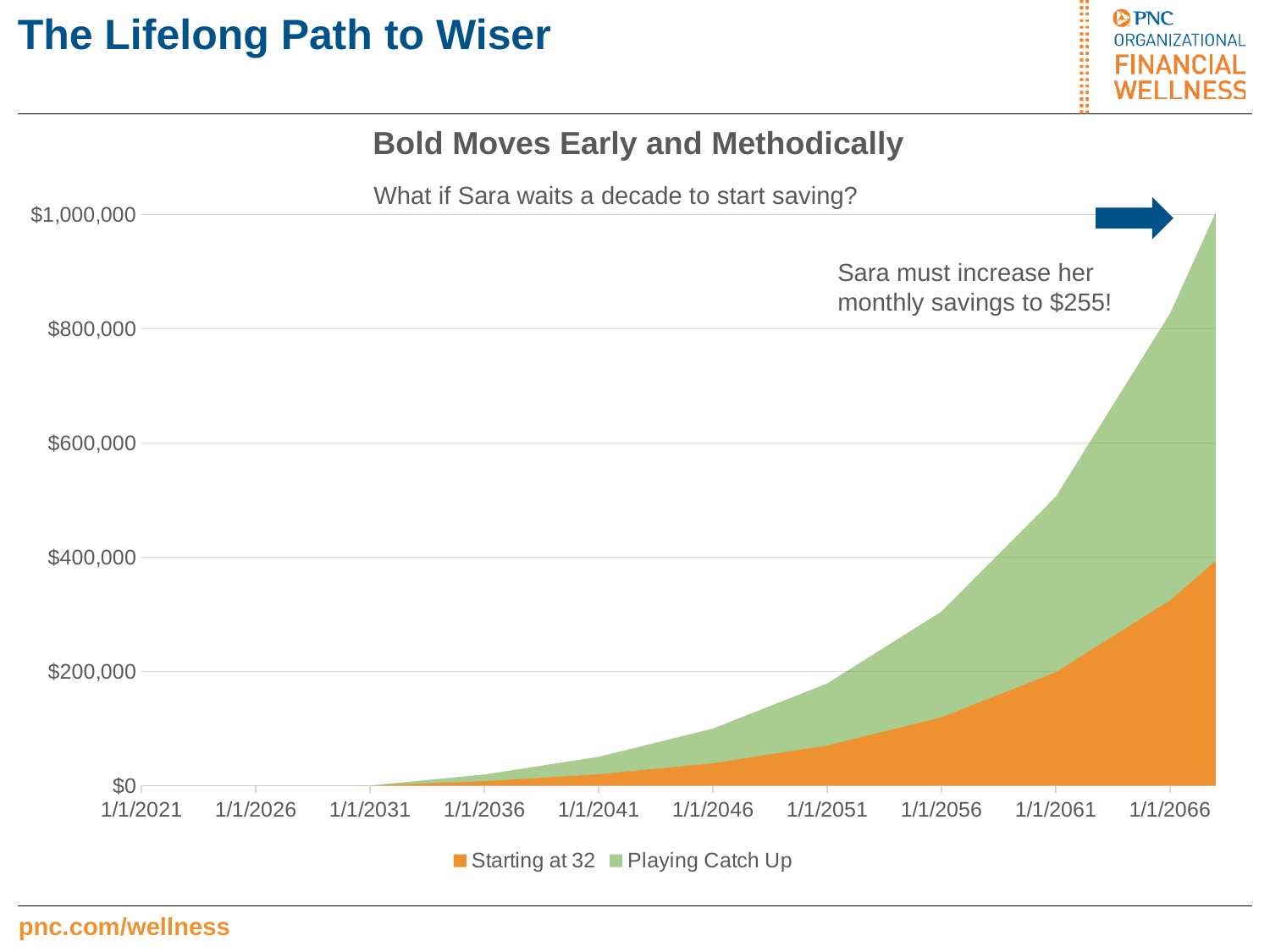
Is the stacked total at 1/1/2056 greater or less than $200,000? greater Is the value for Starting at 32 at 1/1/2056 greater or less than $200,000? less What kind of chart is shown on the slide? Area chart What are the two series named in the legend? Starting at 32 and Playing Catch Up Is the stacked total at 1/1/2061 greater or less than $400,000? greater What is the title of the chart? Bold Moves Early and Methodically How many date labels are shown on the x axis? 10 How many series does the legend list? 2 At 1/1/2066, which series contributes more to the stacked total, Starting at 32 or Playing Catch Up? Playing Catch Up Do the stacked values rise or fall from 1/1/2021 to 1/1/2066? Rise